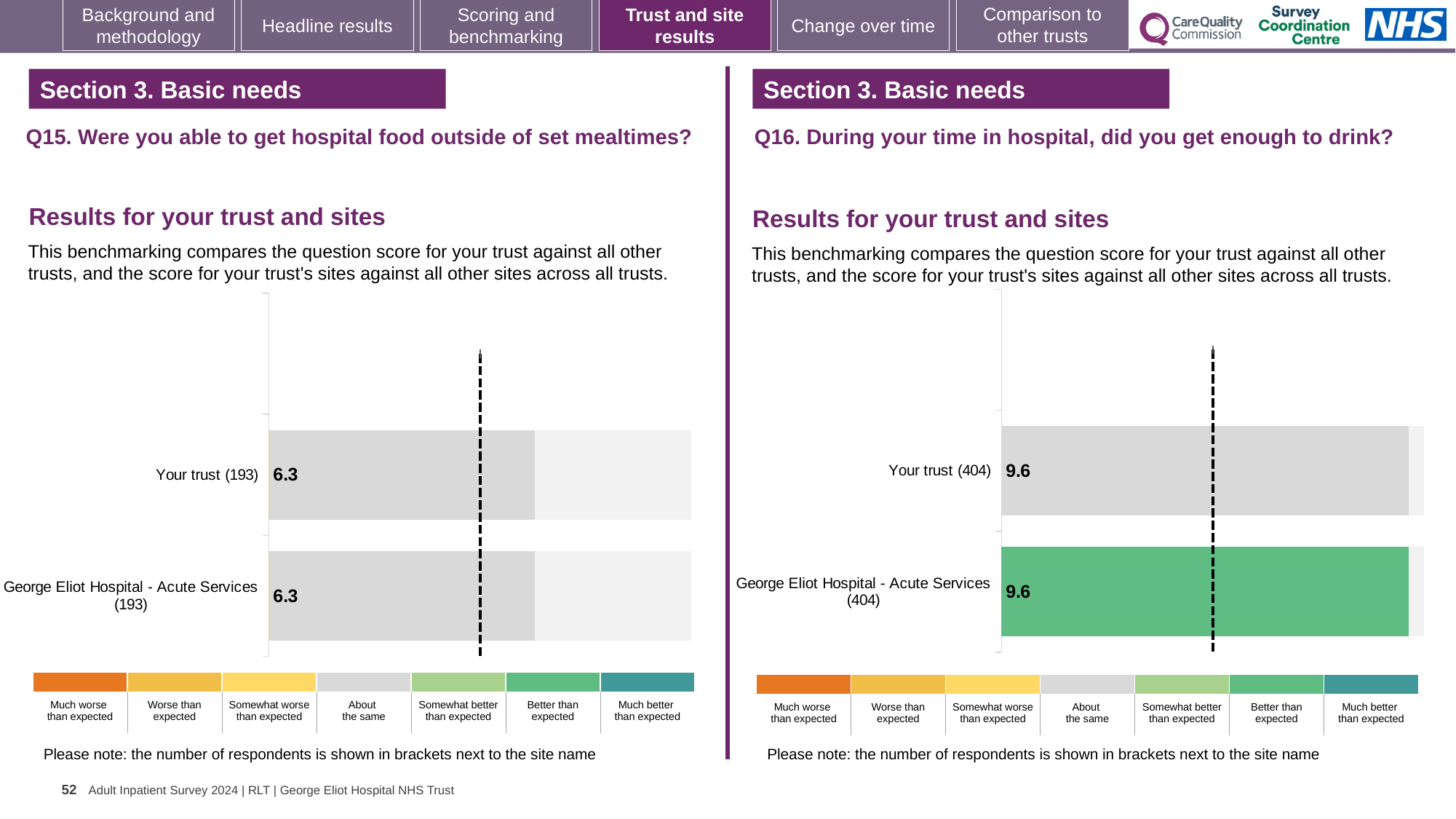
What kind of chart is used for the Q15 results (left)? Bar chart On the Q15 chart (left), what is the difference between the score for Your trust and the score for George Eliot Hospital - Acute Services? 0 According to the colour key below the Q16 chart (right), which category does the green colour of the George Eliot Hospital - Acute Services bar represent? Better than expected On the Q15 chart (left), what is the score for Your trust (193)? 6.3 How many bars are plotted on the Q15 chart (left)? 2 On the Q16 chart (right), what colour is the bar for George Eliot Hospital - Acute Services (404)? Green On the Q16 chart (right), what is the score for George Eliot Hospital - Acute Services (404)? 9.6 How many bars are plotted on the Q16 chart (right)? 2 On the Q16 chart (right), what is the score for Your trust (404)? 9.6 On the Q16 chart (right), what is the difference between the score for Your trust and the score for George Eliot Hospital - Acute Services? 0 On the Q15 chart (left), what is the score for George Eliot Hospital - Acute Services (193)? 6.3 How many respondents are shown in brackets for Your trust on the Q16 chart (right)? 404